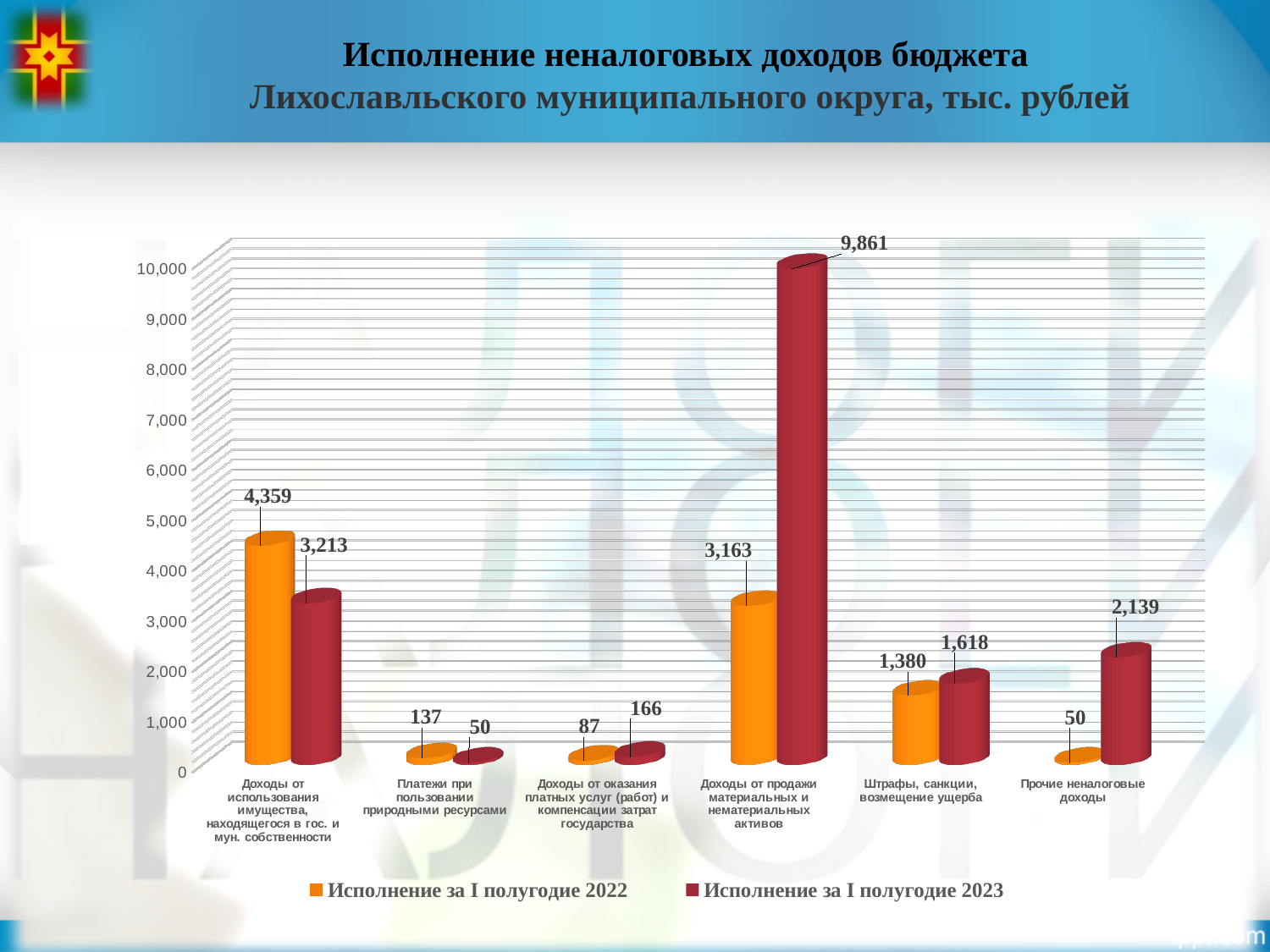
What is the value for 'Доходы от продажи материальных и нематериальных активов' in the series 'Исполнение за I полугодие 2023'? 9,861 What is the difference between the 2022 and 2023 values for 'Платежи при пользовании природными ресурсами'? 87 What is the value for 'Штрафы, санкции, возмещение ущерба' in the series 'Исполнение за I полугодие 2022'? 1,380 How many series does the legend list? 2 What is the difference between the 2023 and 2022 values for 'Доходы от продажи материальных и нематериальных активов'? 6,698 Which category has the lowest value in the series 'Исполнение за I полугодие 2023'? Платежи при пользовании природными ресурсами What is the value for 'Прочие неналоговые доходы' in the series 'Исполнение за I полугодие 2023'? 2,139 Which is larger for 'Доходы от использования имущества, находящегося в гос. и мун. собственности': the value for 'Исполнение за I полугодие 2022' or for 'Исполнение за I полугодие 2023'? Исполнение за I полугодие 2022 How many categories are shown on the x axis? 6 Which category has the highest value in the series 'Исполнение за I полугодие 2022'? Доходы от использования имущества, находящегося в гос. и мун. собственности What type of chart is shown on the slide? bar chart Which colour represents the series 'Исполнение за I полугодие 2023'? red